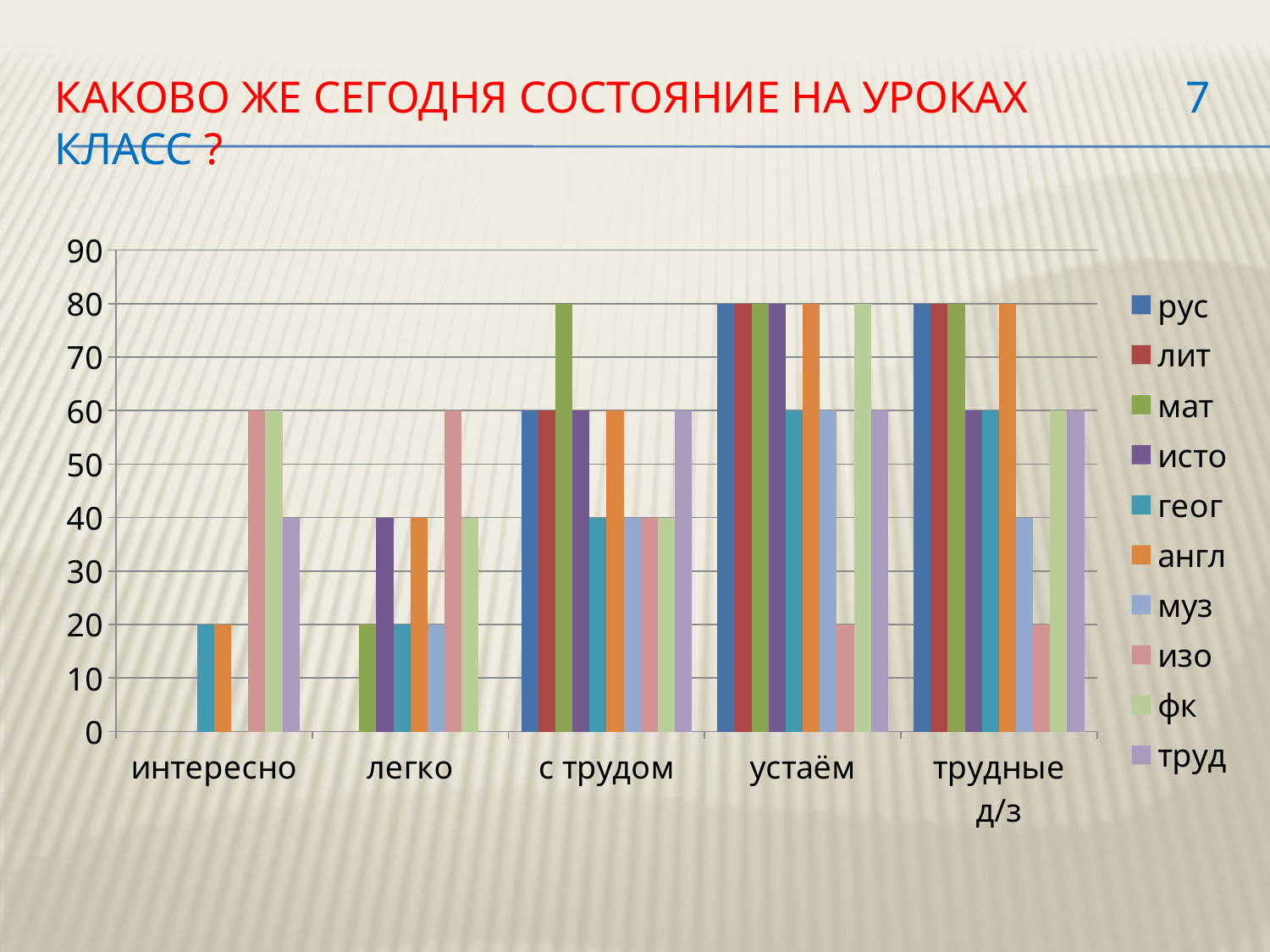
How many categories are shown on the x axis of the chart? 5 Which series has the lowest value in the category устаём? изо In the category легко, which is larger: the value for изо or the value for мат? изо Which series is shown in orange in the chart legend? англ What kind of chart is shown on the slide? bar chart What is the value for изо in the category интересно? 60 What is the value for мат in the category с трудом? 80 Which series has the highest value in the category с трудом? мат What is the value for муз in the category трудные д/з? 40 What is the value for изо in the category устаём? 20 What is the difference between the value for мат and the value for геог in the category с трудом? 40 How many series does the chart legend list? 10